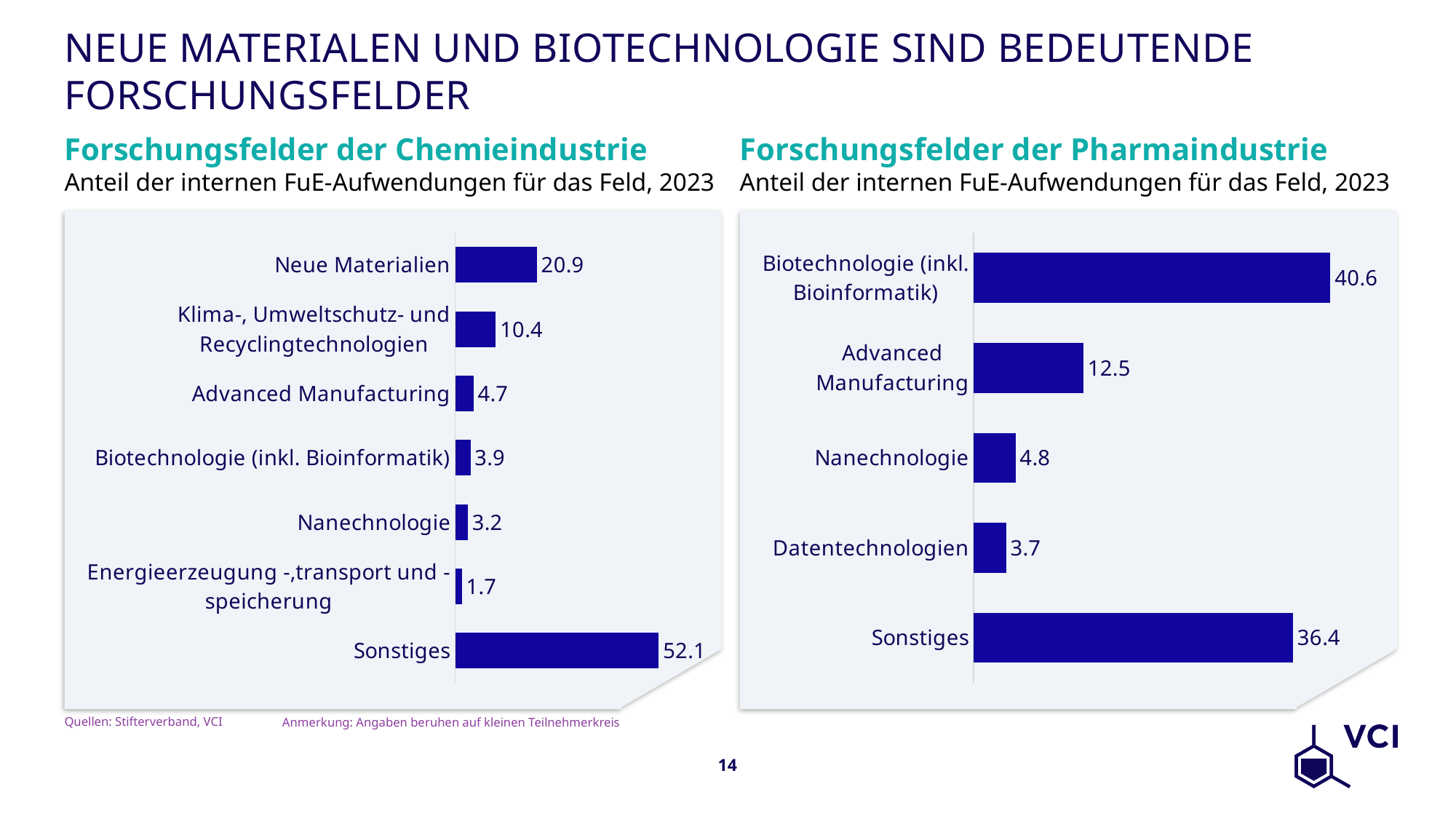
In the 'Forschungsfelder der Pharmaindustrie' chart, what is the difference between Advanced Manufacturing and Nanechnologie? 7.7 In the 'Forschungsfelder der Pharmaindustrie' chart, what is the value for Biotechnologie (inkl. Bioinformatik)? 40.6 In the 'Forschungsfelder der Chemieindustrie' chart, what is the value for Nanechnologie? 3.2 In the 'Forschungsfelder der Chemieindustrie' chart, what is the value for Neue Materialien? 20.9 In the 'Forschungsfelder der Chemieindustrie' chart, which category has the lowest value? Energieerzeugung -,transport und -speicherung In the 'Forschungsfelder der Pharmaindustrie' chart, which is larger: Datentechnologien or Sonstiges? Sonstiges How many categories are shown in the 'Forschungsfelder der Pharmaindustrie' chart? 5 In the 'Forschungsfelder der Pharmaindustrie' chart, which category has the highest value? Biotechnologie (inkl. Bioinformatik) How many categories are shown in the 'Forschungsfelder der Chemieindustrie' chart? 7 In the 'Forschungsfelder der Chemieindustrie' chart, which is larger: Klima-, Umweltschutz- und Recyclingtechnologien or Advanced Manufacturing? Klima-, Umweltschutz- und Recyclingtechnologien In the 'Forschungsfelder der Chemieindustrie' chart, what is the difference between Sonstiges and Neue Materialien? 31.2 What kind of chart is the 'Forschungsfelder der Pharmaindustrie' chart? Bar chart